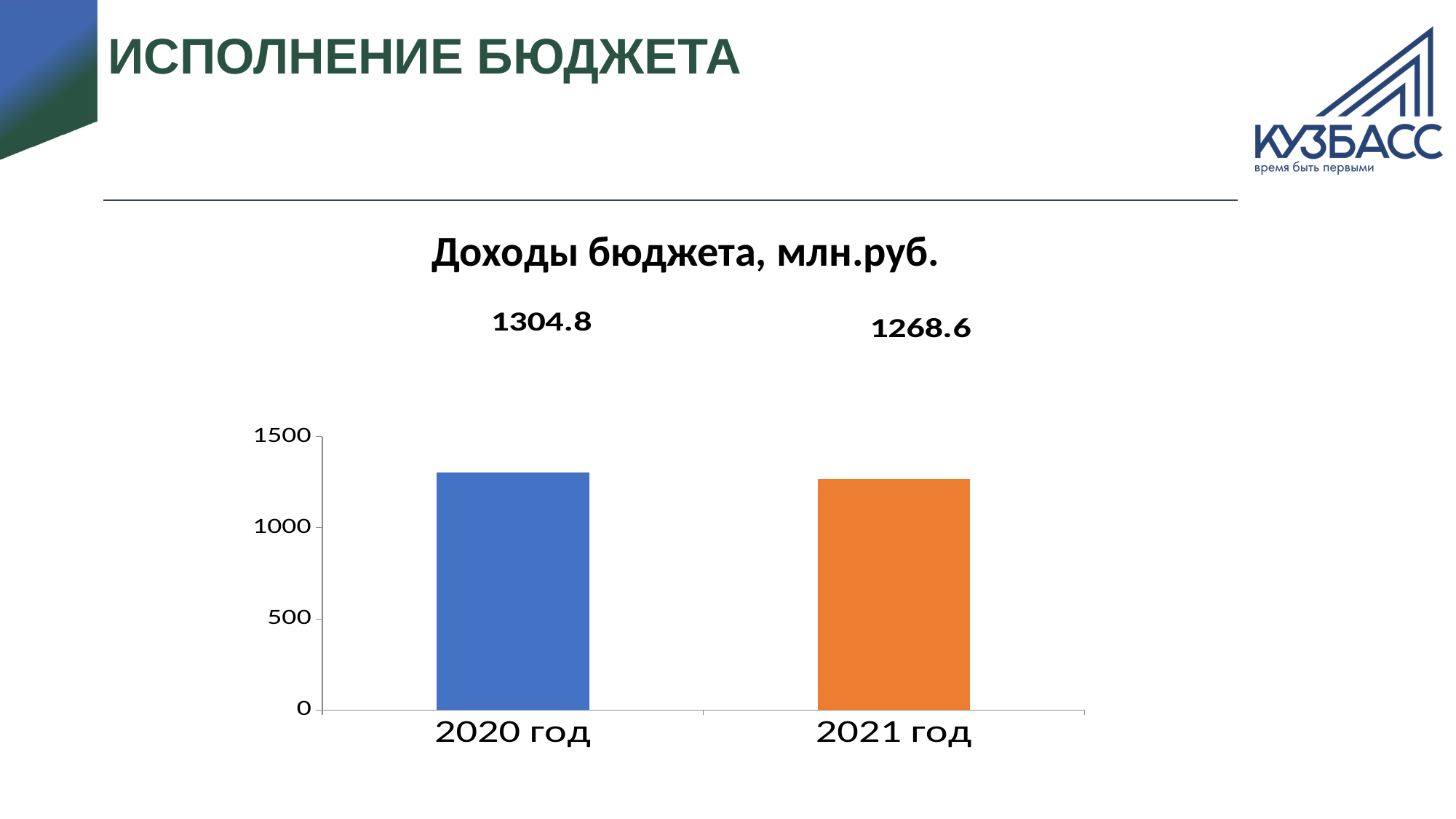
What is the value for 2021 год? 1268.6 Which year has the lowest budget revenue? 2021 год Is the value for 2020 год greater or less than 1500? less How many categories are shown in the chart? 2 Which year has the highest budget revenue? 2020 год What kind of chart is shown on the slide? bar chart What is the value for 2020 год? 1304.8 Which is larger, the value for 2020 год or 2021 год? 2020 год Is the value for 2021 год greater or less than 1000? greater What is the difference between the values for 2020 год and 2021 год? 36.2 What is the title of the chart? Доходы бюджета, млн.руб. Do the values rise or fall from 2020 год to 2021 год? fall